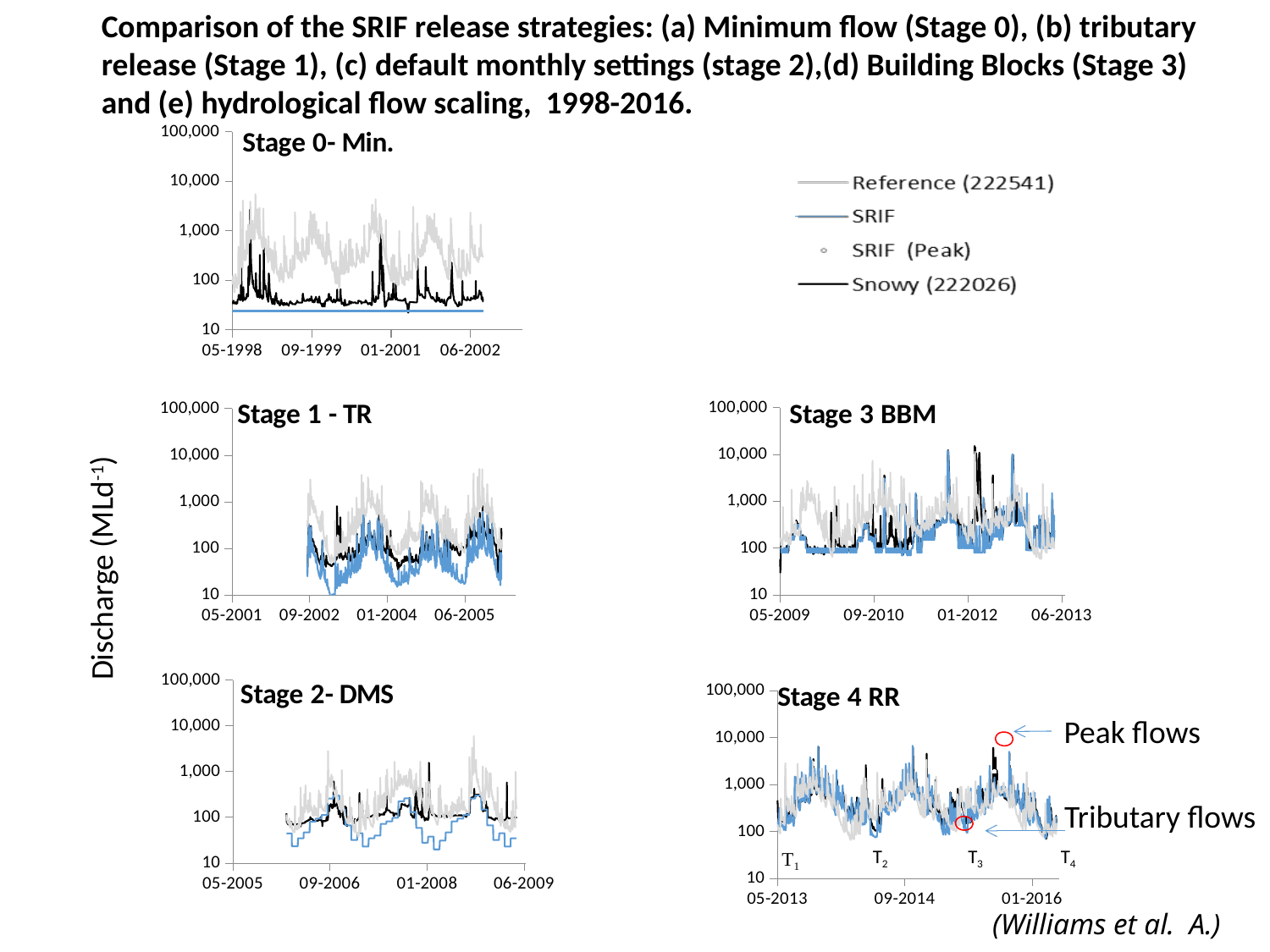
In the Stage 0- Min. chart, is the flat SRIF (blue) line greater or less than 100? less What kind of chart is the Stage 0- Min. chart? Line chart In the Stage 0- Min. chart, is the highest Reference value greater or less than 1,000? greater How many charts are shown on the slide? 5 Which legend entry is drawn as a black line? Snowy (222026) How many series does the legend list? 4 What is the label of the shared y axis? Discharge (MLd⁻¹) In the Stage 2- DMS chart, is the highest SRIF (blue) value greater or less than 1,000? less